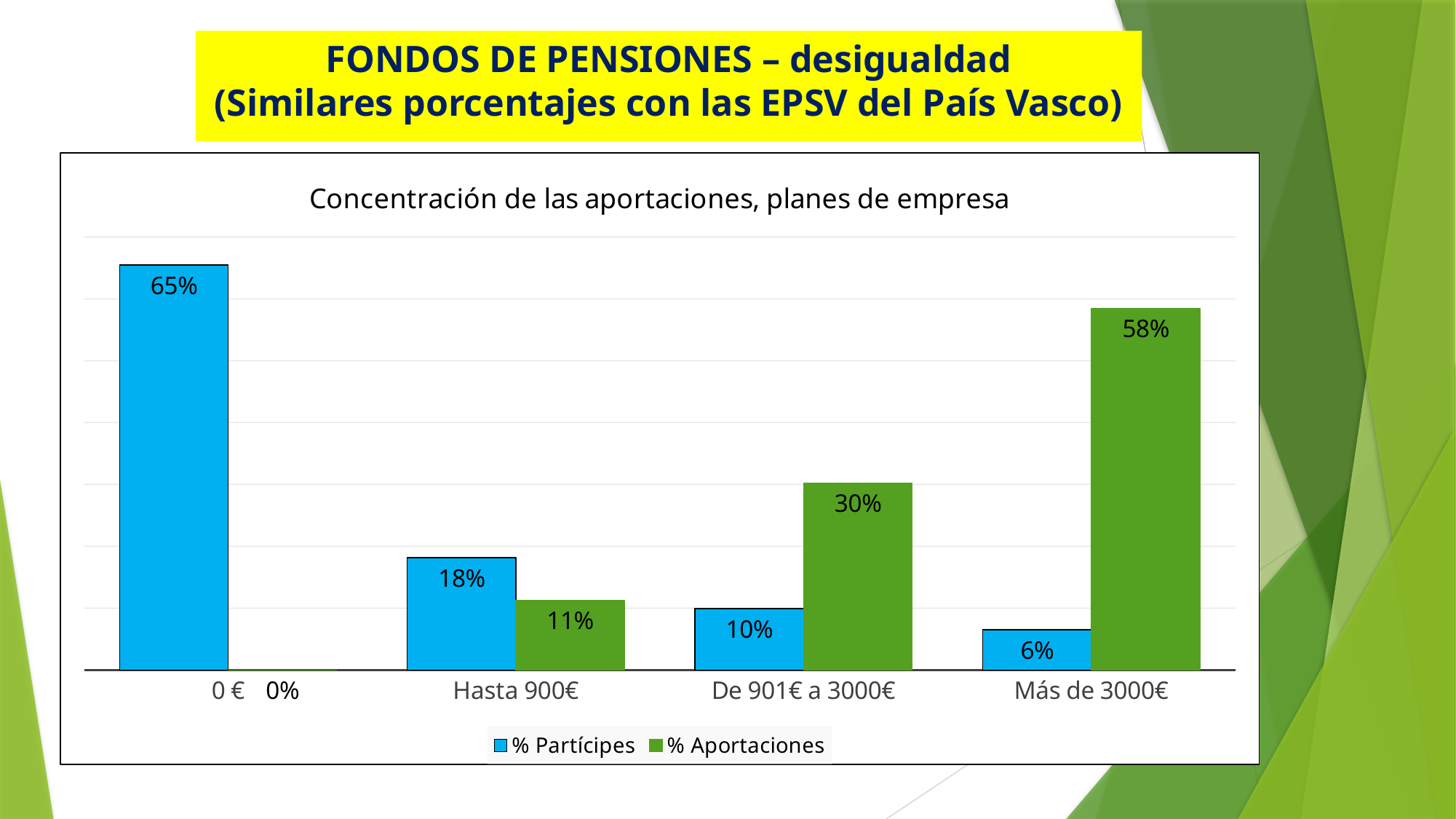
How many categories are shown on the x axis? 4 Do the % Partícipes values rise or fall from left to right along the x axis? Fall What is the % Aportaciones value for the De 901€ a 3000€ category? 30% What kind of chart is shown on the slide? Bar chart What is the % Aportaciones value for the Más de 3000€ category? 58% What is the difference between the % Aportaciones and % Partícipes values for the Más de 3000€ category? 52% What is the % Partícipes value for the 0 € category? 65% What is the % Partícipes value for the Hasta 900€ category? 18% For the Hasta 900€ category, which is larger: % Partícipes or % Aportaciones? % Partícipes How many series does the legend list? 2 Which category has the lowest % Aportaciones value? 0 € Which category has the highest % Partícipes value? 0 €